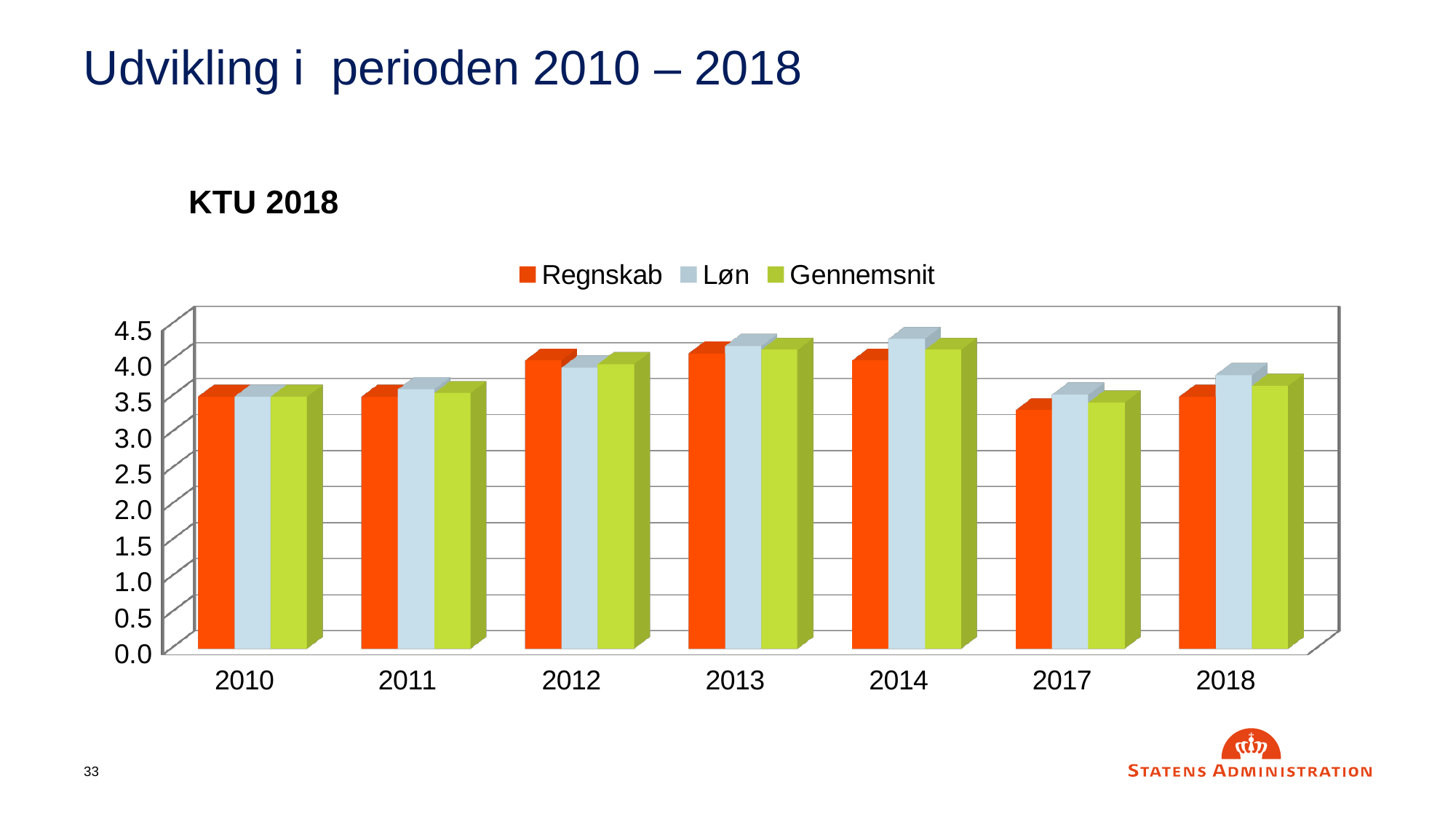
In which year is the Regnskab value lowest? 2017 Which series is shown in orange in the legend? Regnskab Is the value for Gennemsnit in 2010 greater or less than 4.0? less What is the title of the chart? KTU 2018 Which is larger, the Løn value in 2014 or the Løn value in 2017? 2014 Is the value for Regnskab in 2017 greater or less than 4.0? less Is the value for Løn in 2014 greater or less than 4.0? greater How many series does the legend list? 3 Which is larger, the Regnskab value in 2012 or the Regnskab value in 2010? 2012 What kind of chart is shown on the slide? bar chart How many years are shown on the x axis? 7